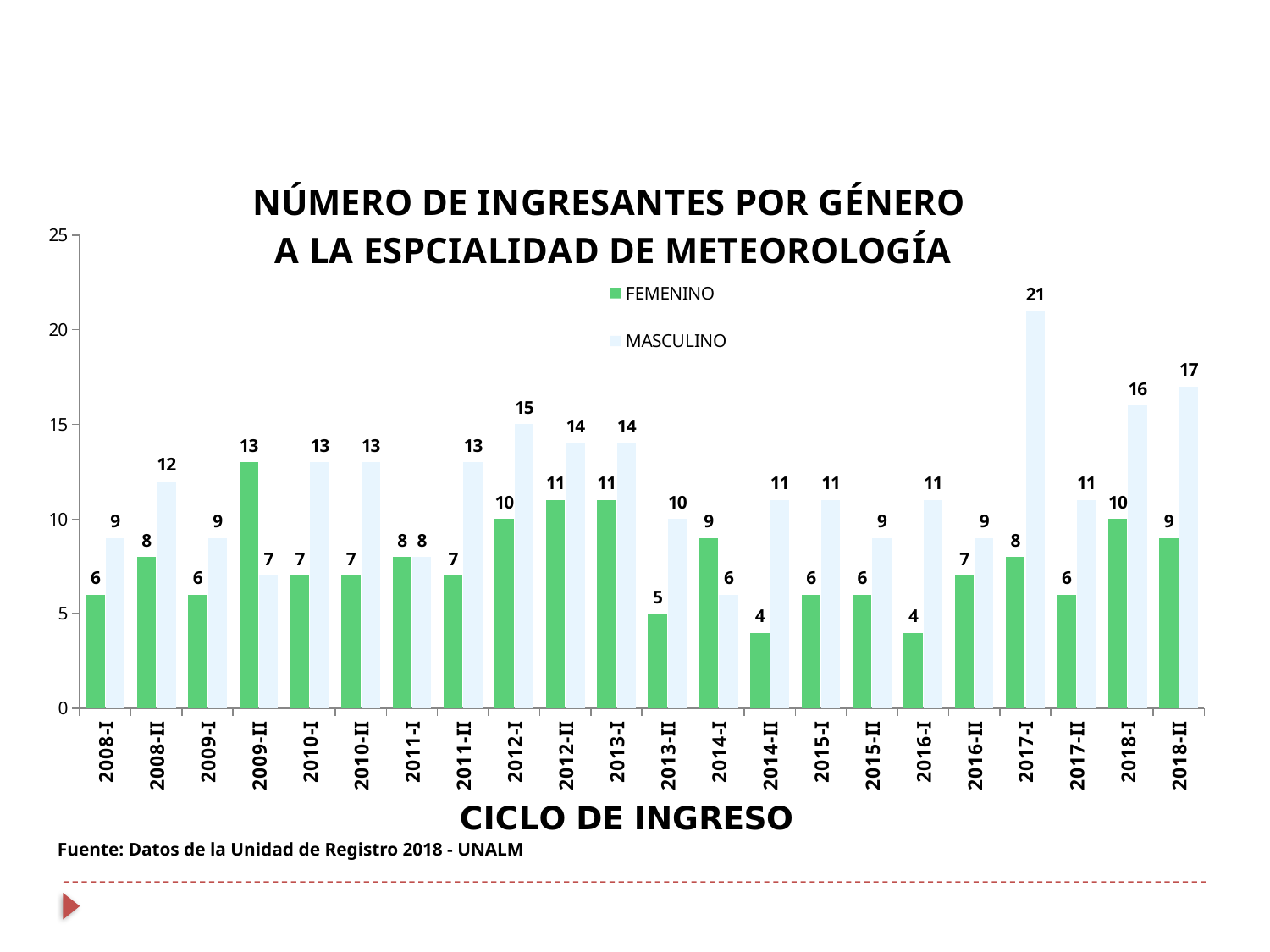
What kind of chart is shown on the slide? bar chart Is the MASCULINO value for 2018-II greater or less than 15? greater Which ciclo de ingreso has the highest FEMENINO value? 2009-II Which ciclo de ingreso has the highest MASCULINO value? 2017-I Which is larger for 2014-I, the FEMENINO value or the MASCULINO value? FEMENINO How many ciclos de ingreso are shown on the x axis? 22 What is the difference between the MASCULINO and FEMENINO values for 2017-I? 13 What is the FEMENINO value for 2009-II? 13 Which ciclo de ingreso has the lowest MASCULINO value? 2014-I How many series does the legend list? 2 What is the MASCULINO value for 2012-I? 15 What is the MASCULINO value for 2017-I? 21